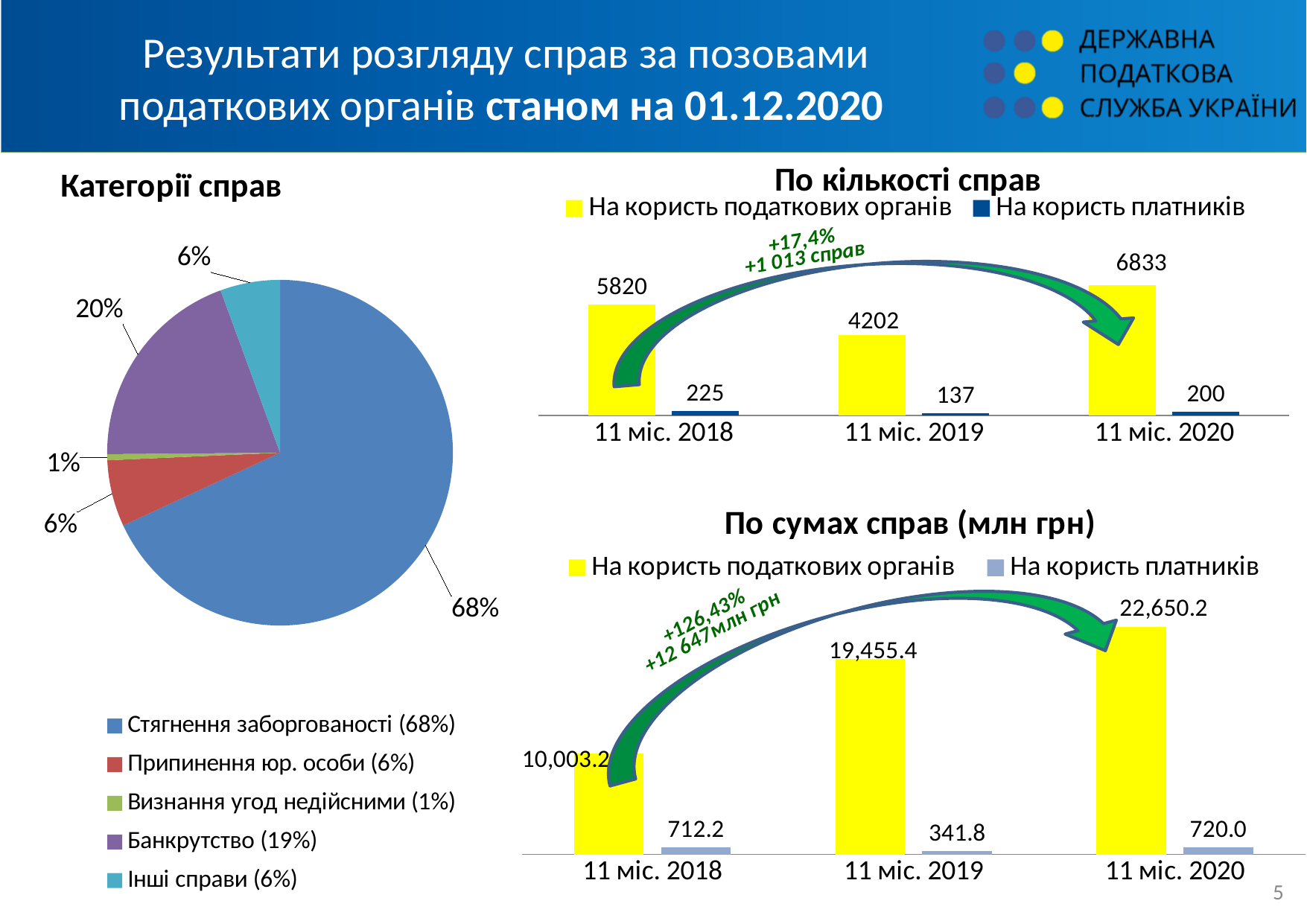
In the chart 'По сумах справ (млн грн)', how many periods are shown on the x axis? 3 What kind of chart is 'Категорії справ'? pie chart In the chart 'По сумах справ (млн грн)', do the values for 'На користь податкових органів' rise or fall from 11 міс. 2018 to 11 міс. 2020? rise In the chart 'По кількості справ', which period has the lowest value for 'На користь платників'? 11 міс. 2019 In the chart 'По кількості справ', what is the difference between the 'На користь податкових органів' values for 11 міс. 2020 and 11 міс. 2018? 1013 In the chart 'По кількості справ', what is the value for 'На користь податкових органів' in 11 міс. 2019? 4202 In the chart 'По сумах справ (млн грн)', what is the value for 'На користь податкових органів' in 11 міс. 2020? 22,650.2 In the chart 'По кількості справ', which period has the highest value for 'На користь податкових органів'? 11 міс. 2020 In the chart 'По сумах справ (млн грн)', what is the value for 'На користь платників' in 11 міс. 2018? 712.2 In the pie chart 'Категорії справ', what share does 'Стягнення заборгованості' have? 68% In the chart 'По кількості справ', how many series does the legend list? 2 In the chart 'По сумах справ (млн грн)', which is larger for 'На користь податкових органів': 11 міс. 2019 or 11 міс. 2020? 11 міс. 2020